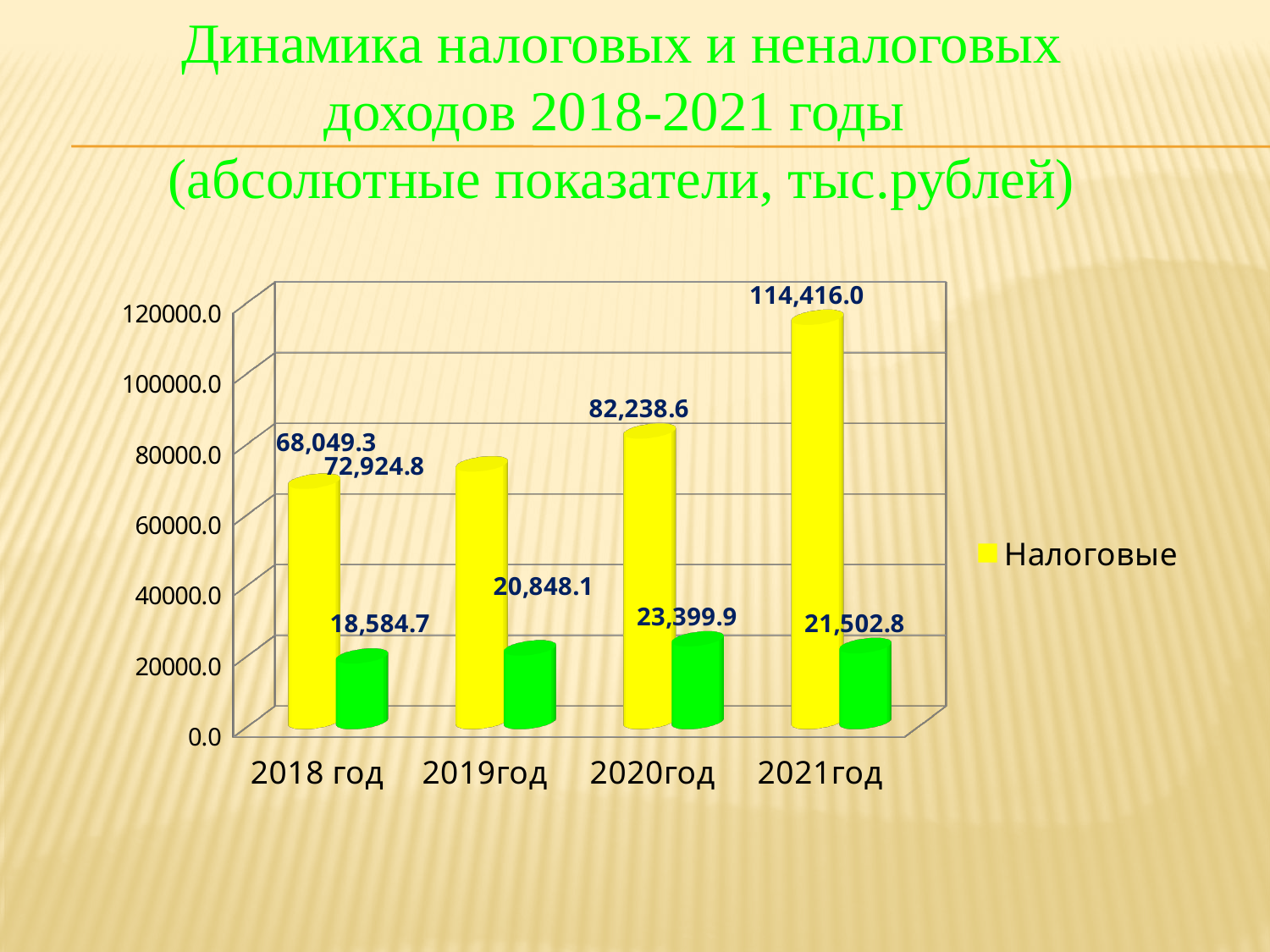
What is the difference between the Налоговые values for 2021год and 2020год? 32,177.4 What is the value for Налоговые in 2021год? 114,416.0 Which is larger: the green bar for 2020год or the green bar for 2021год? 2020год What is the value of the green bar for 2019год? 20,848.1 What type of chart is shown on the slide? bar chart Do the Налоговые values rise or fall from 2018 год to 2021год? rise How many years are shown on the x axis? 4 Which series name is listed in the legend? Налоговые What is the value for Налоговые in 2018 год? 68,049.3 In which year is the green bar lowest? 2018 год What is the value of the green bar for 2020год? 23,399.9 In which year is the Налоговые value highest? 2021год